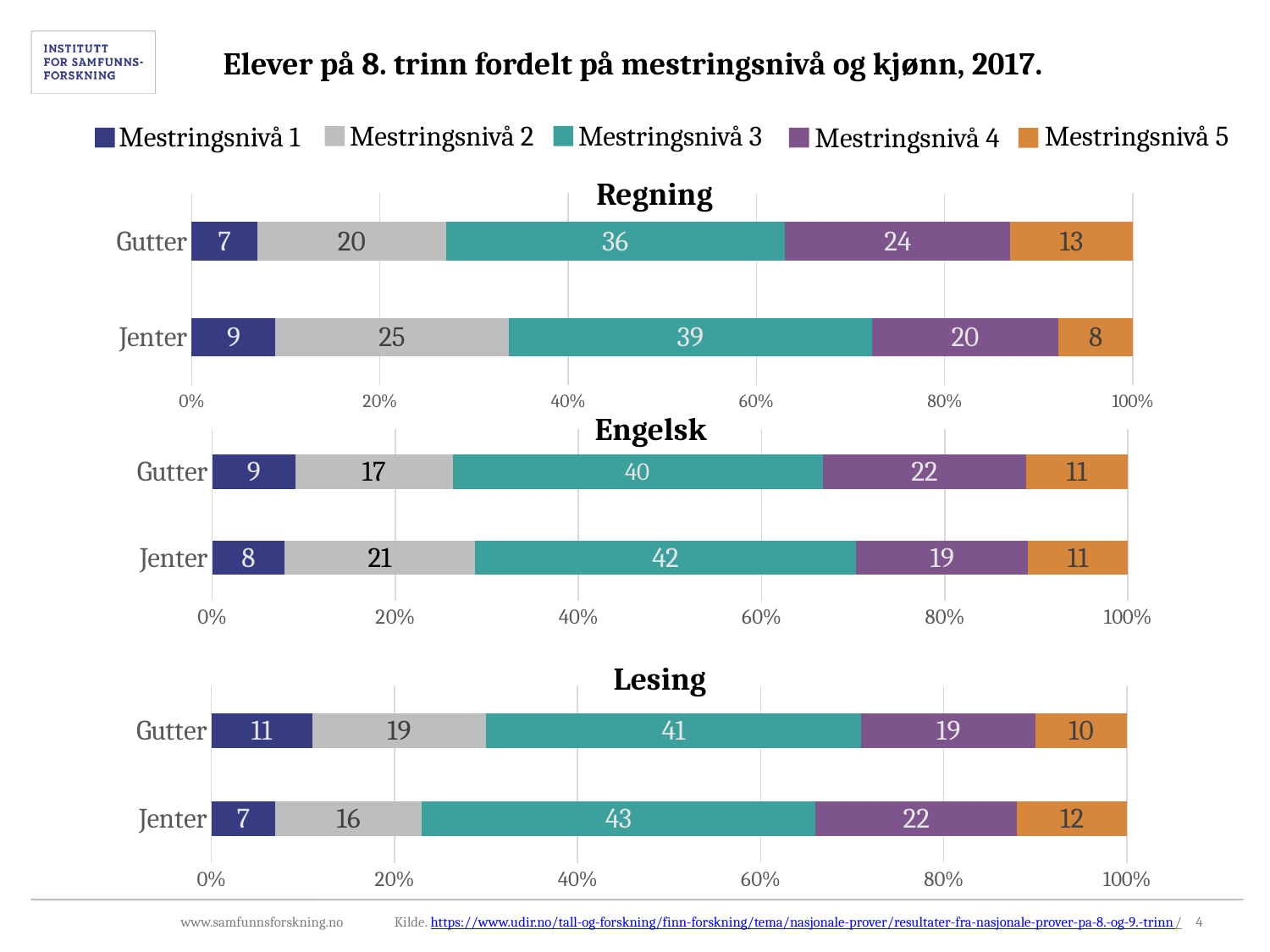
In the Regning chart, what is the value of Mestringsnivå 5 for Jenter? 8 In the Regning chart, what is the value of Mestringsnivå 3 for Gutter? 36 How many charts are shown on the slide? 3 In the Regning chart, what is the total of the Gutter bar? 100 In the Lesing chart, which is larger: Mestringsnivå 3 for Gutter or Mestringsnivå 3 for Jenter? Jenter In the Regning chart, what is the difference between the Mestringsnivå 4 values for Gutter and Jenter? 4 In the Engelsk chart, what is the value of Mestringsnivå 2 for Jenter? 21 In the Lesing chart, what is the value of Mestringsnivå 1 for Gutter? 11 In the Engelsk chart, which mestringsnivå has the lowest value for Gutter? Mestringsnivå 1 In the Lesing chart, which mestringsnivå has the highest value for Jenter? Mestringsnivå 3 What kind of chart is the Engelsk chart? Stacked bar chart How many series does the legend list? 5